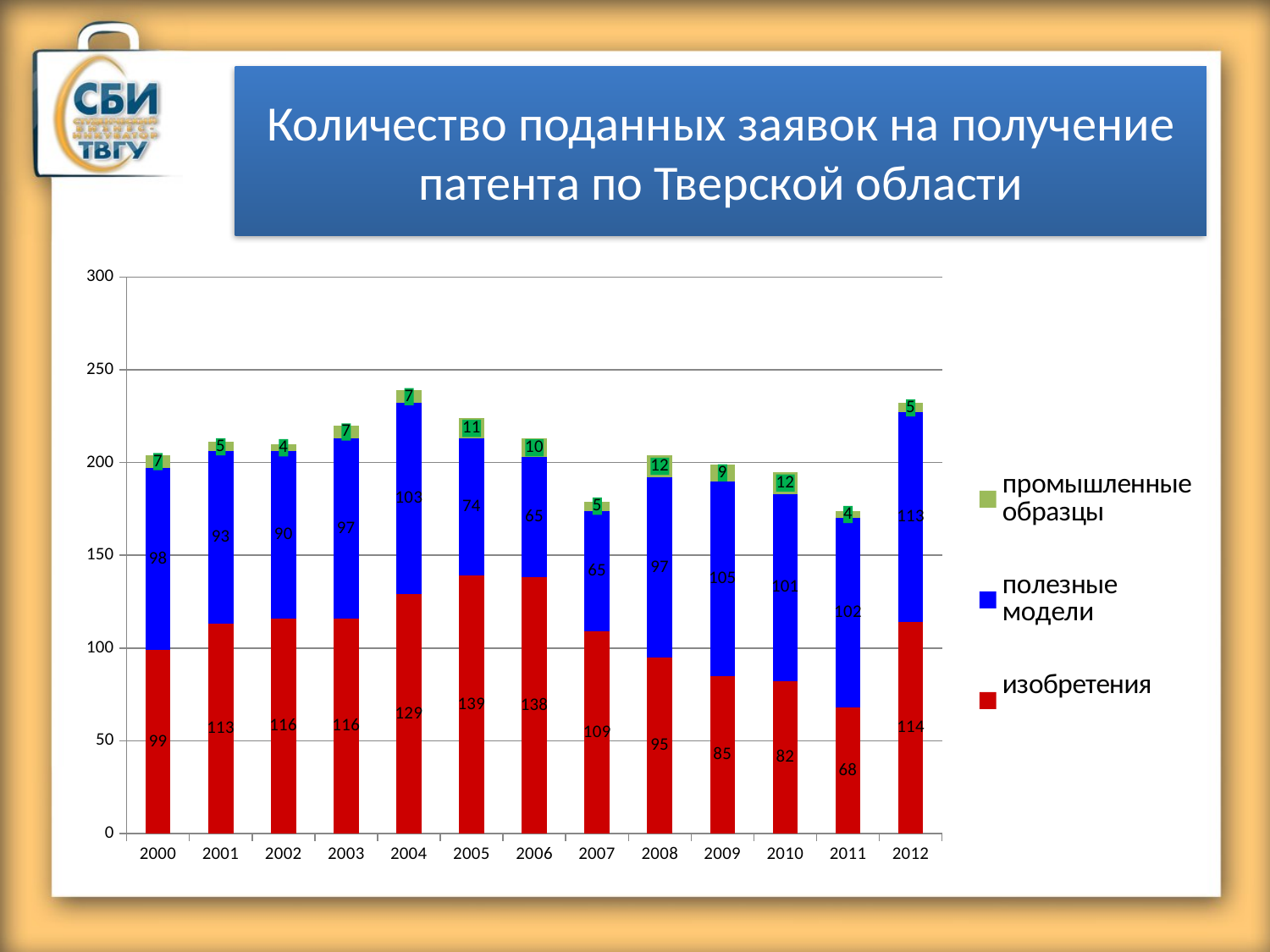
In which year is the value for изобретения the lowest? 2011 What kind of chart is shown on the slide? stacked bar chart Which series is shown in red? изобретения What is the total of the stacked bar for 2004? 239 In which year is the value for изобретения the highest? 2005 What is the value for полезные модели in 2004? 103 What is the value for изобретения in 2005? 139 How many series does the legend list? 3 What is the difference between the изобретения values for 2004 and 2011? 61 Which is larger: полезные модели in 2009 or полезные модели in 2006? 2009 How many years are shown on the x axis? 13 What is the value for промышленные образцы in 2008? 12